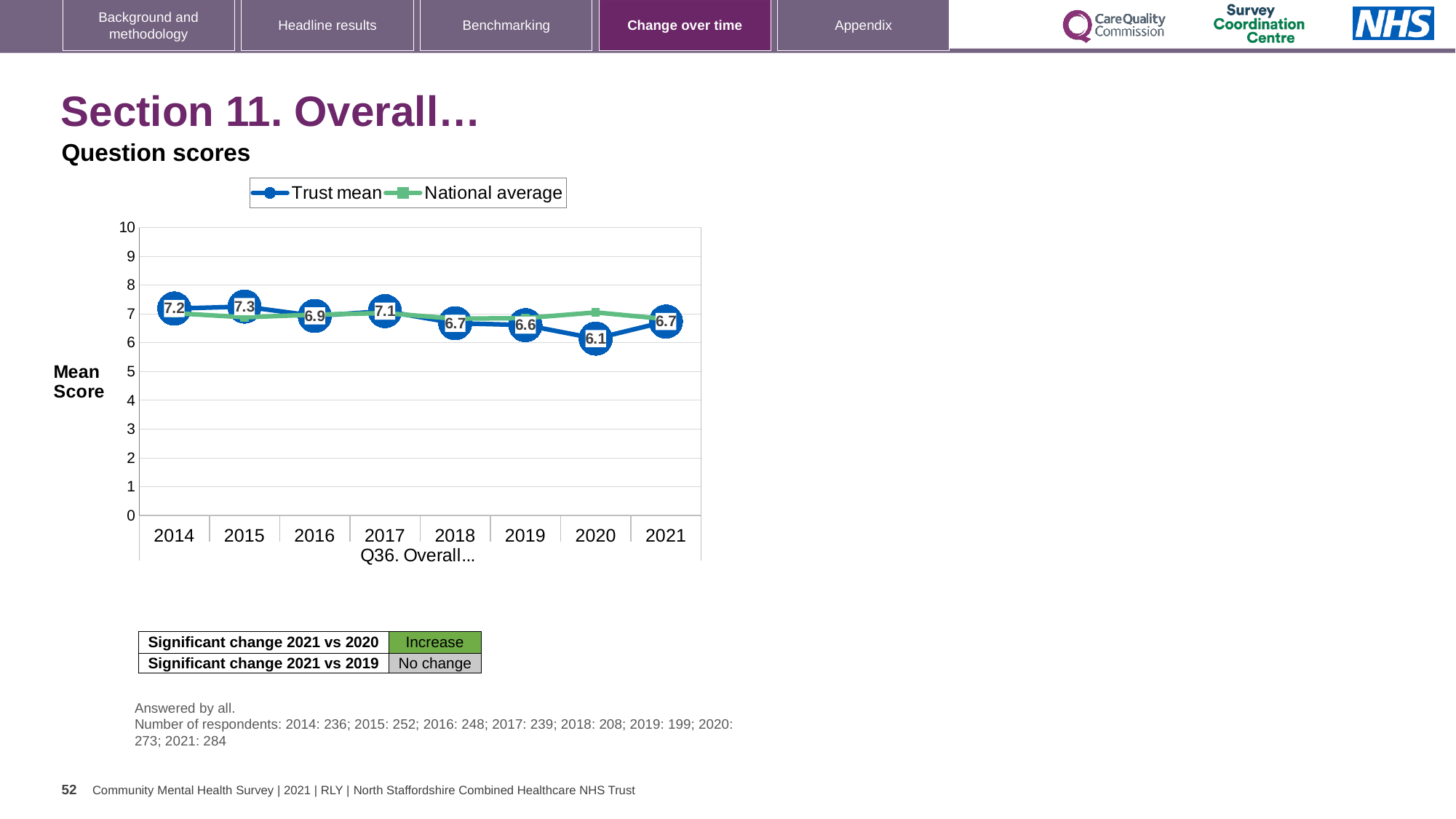
How many years are shown on the x axis? 8 In which year is the Trust mean score lowest? 2020 What is the Trust mean score for 2020? 6.1 What is the label on the y axis? Mean Score What is the Trust mean score for 2021? 6.7 Is the Trust mean score for 2020 greater or less than 7? less How many series does the legend list? 2 Which is larger, the Trust mean score for 2014 or for 2016? 2014 What is the Trust mean score for 2015? 7.3 In which year is the Trust mean score highest? 2015 What is the difference between the Trust mean scores for 2015 and 2020? 1.2 What kind of chart is shown? line chart